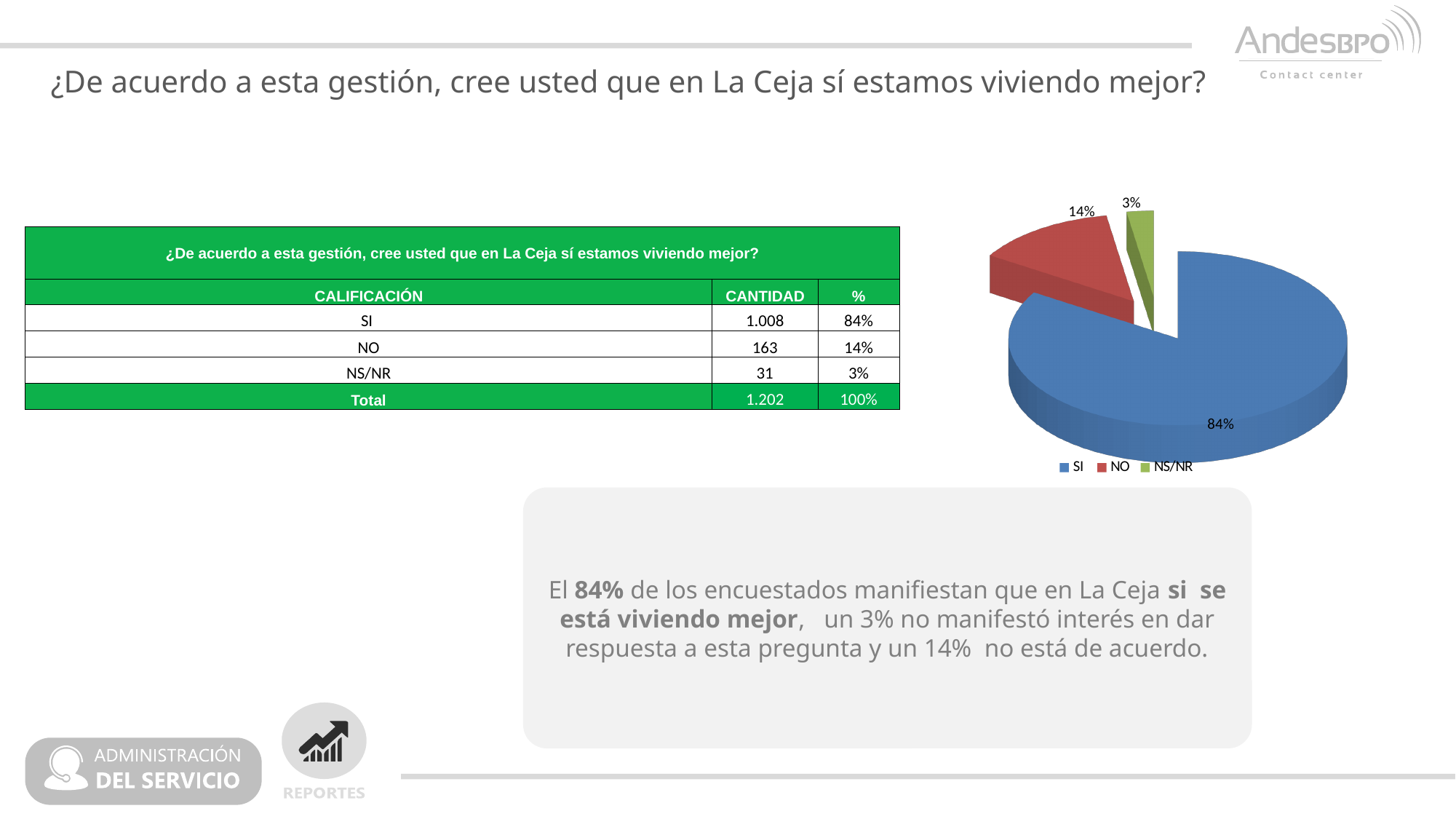
How many slices does the pie chart have? 3 Which category has the smallest slice in the pie chart? NS/NR What colour is the NO slice in the pie chart? red What percentage does the NS/NR slice of the pie chart represent? 3% What percentage does the NO slice of the pie chart represent? 14% What kind of chart is shown on the slide? pie chart What is the difference in percentage points between the SI slice and the NO slice? 70 Which slice is larger in the pie chart, NO or NS/NR? NO What percentage does the SI slice of the pie chart represent? 84% What colour is the SI slice in the pie chart? blue Which category has the largest slice in the pie chart? SI How many entries does the pie chart legend list? 3